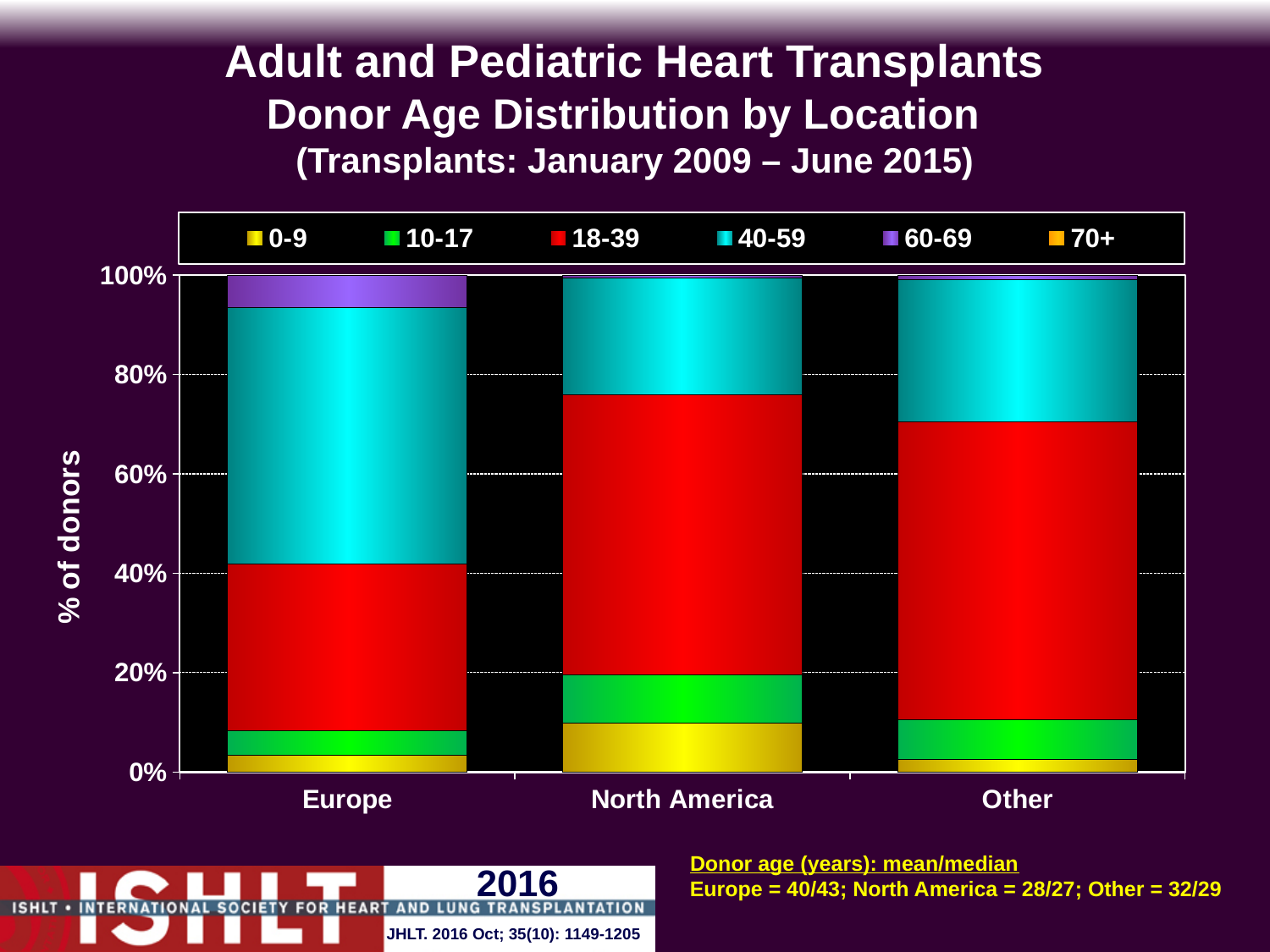
What is the label of the y axis of the chart? % of donors What kind of chart is shown on the slide? Stacked bar chart Is the share of donors aged 18-39 larger in North America or in Europe? North America Is the share of donors aged 18-39 in Other greater or less than 40%? greater How many locations are shown on the x axis of the chart? 3 Which location has the largest share of donors aged 0-9? North America Is the share of donors aged 40-59 in Europe greater or less than 40%? greater How many donor age groups does the legend list? 6 Is the share of donors aged 40-59 larger in Europe or in North America? Europe Is the share of donors aged 60-69 in Europe greater or less than 20%? less Which location has the largest share of donors aged 40-59? Europe Which location has the largest share of donors aged 60-69? Europe